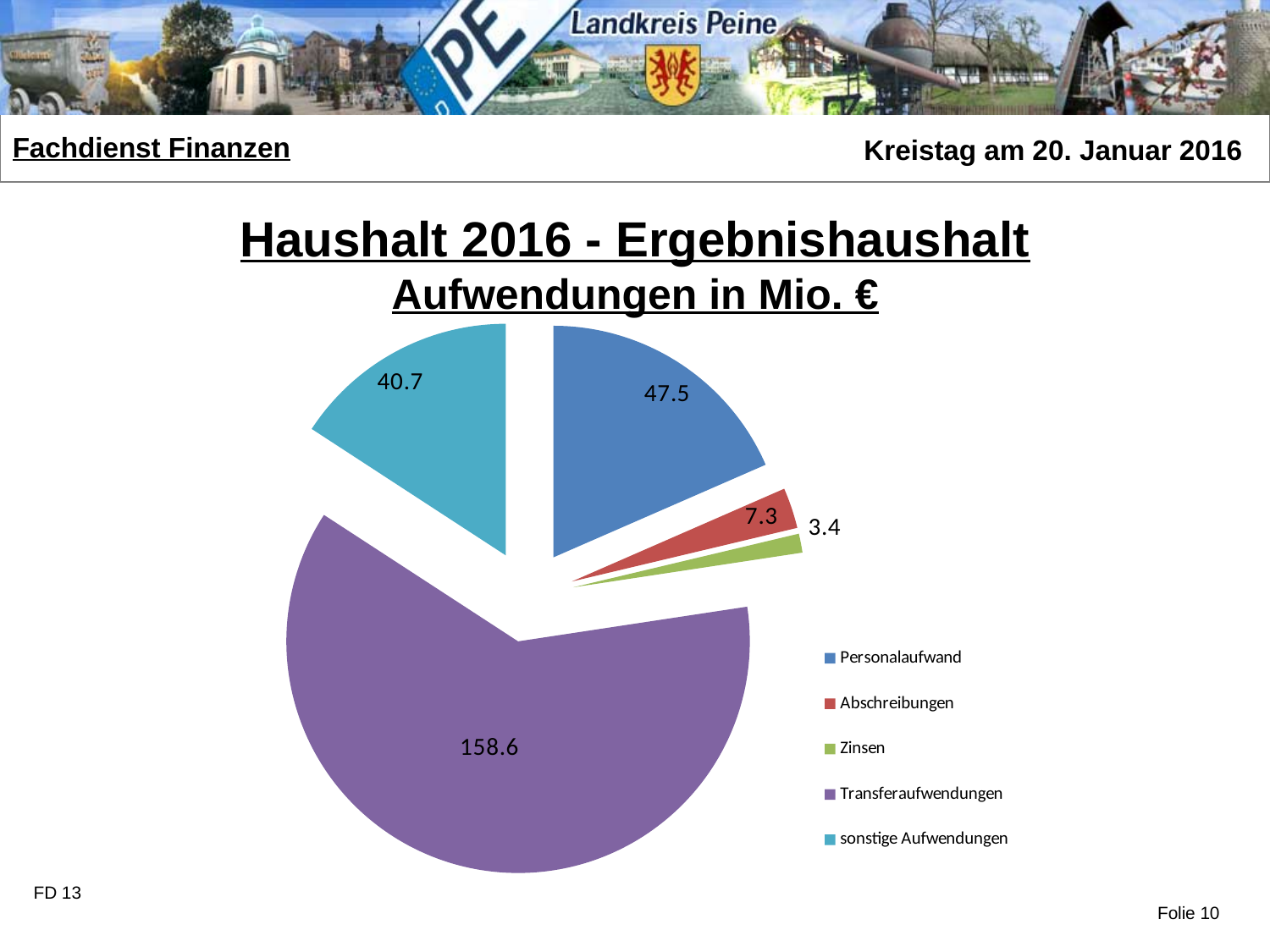
Which category has the largest slice in the pie chart? Transferaufwendungen Which category has the smallest slice in the pie chart? Zinsen What kind of chart is shown on the slide? Pie chart What is the total of all slices in the pie chart? 257.5 What is the value for Zinsen in the pie chart? 3.4 What is the value for Transferaufwendungen in the pie chart? 158.6 What is the difference between the values for Abschreibungen and Zinsen? 3.9 What is the value for Personalaufwand in the pie chart? 47.5 What is the difference between the values for Personalaufwand and sonstige Aufwendungen? 6.8 How many categories does the pie chart show? 5 Which is larger, the value for Personalaufwand or the value for sonstige Aufwendungen? Personalaufwand What is the value for sonstige Aufwendungen in the pie chart? 40.7